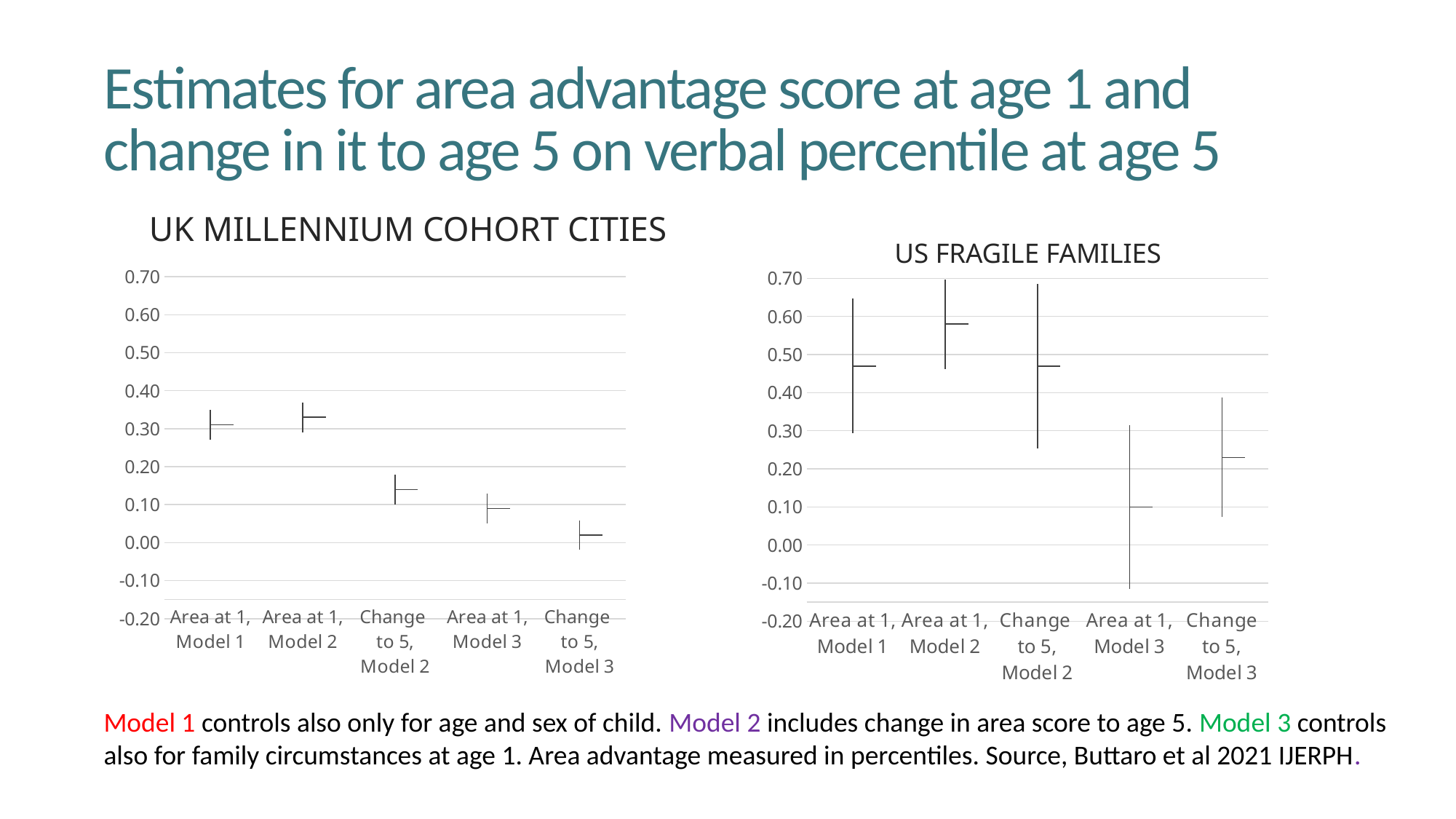
What are the titles of the two charts on the slide? UK MILLENNIUM COHORT CITIES and US FRAGILE FAMILIES On the UK MILLENNIUM COHORT CITIES chart, which has the larger point estimate: Area at 1, Model 1 or Change to 5, Model 2? Area at 1, Model 1 On the US FRAGILE FAMILIES chart, is the point estimate for Area at 1, Model 2 greater or less than 0.50? greater On the US FRAGILE FAMILIES chart, which has the larger point estimate: Area at 1, Model 2 or Change to 5, Model 3? Area at 1, Model 2 On the US FRAGILE FAMILIES chart, which category has the highest point estimate? Area at 1, Model 2 On the US FRAGILE FAMILIES chart, which category has the lowest point estimate? Area at 1, Model 3 On the UK MILLENNIUM COHORT CITIES chart, which category has the lowest point estimate? Change to 5, Model 3 On the UK MILLENNIUM COHORT CITIES chart, how many categories are shown on the x axis? 5 On the US FRAGILE FAMILIES chart, what is the highest value labelled on the y axis? 0.70 On the UK MILLENNIUM COHORT CITIES chart, is the point estimate for Change to 5, Model 3 greater or less than 0.10? less On the US FRAGILE FAMILIES chart, is the point estimate for Area at 1, Model 3 greater or less than 0.20? less